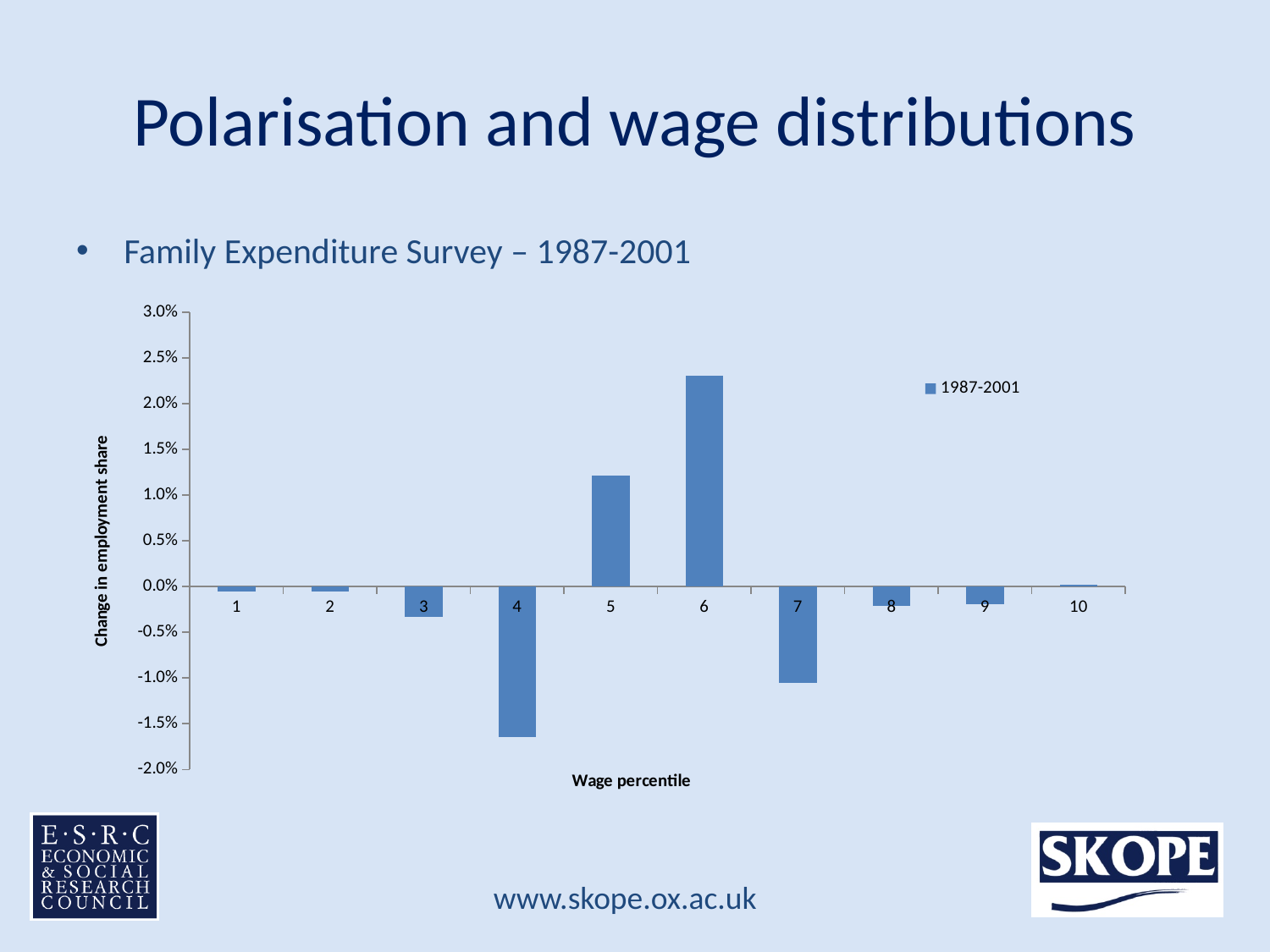
Which wage percentile has the highest change in employment share? 6 Is the value for wage percentile 5 greater or less than 1.0%? greater What is the title of the vertical axis? Change in employment share How many series does the legend list? 1 What series name is shown in the legend? 1987-2001 How many wage percentile categories are plotted on the x axis? 10 Which has the larger change in employment share, wage percentile 5 or wage percentile 6? 6 Is the value for wage percentile 4 greater or less than -1.5%? less Is the value for wage percentile 6 greater or less than 2.0%? greater What kind of chart is shown on the slide? bar chart Which has the lower change in employment share, wage percentile 4 or wage percentile 7? 4 Which wage percentile has the lowest change in employment share? 4